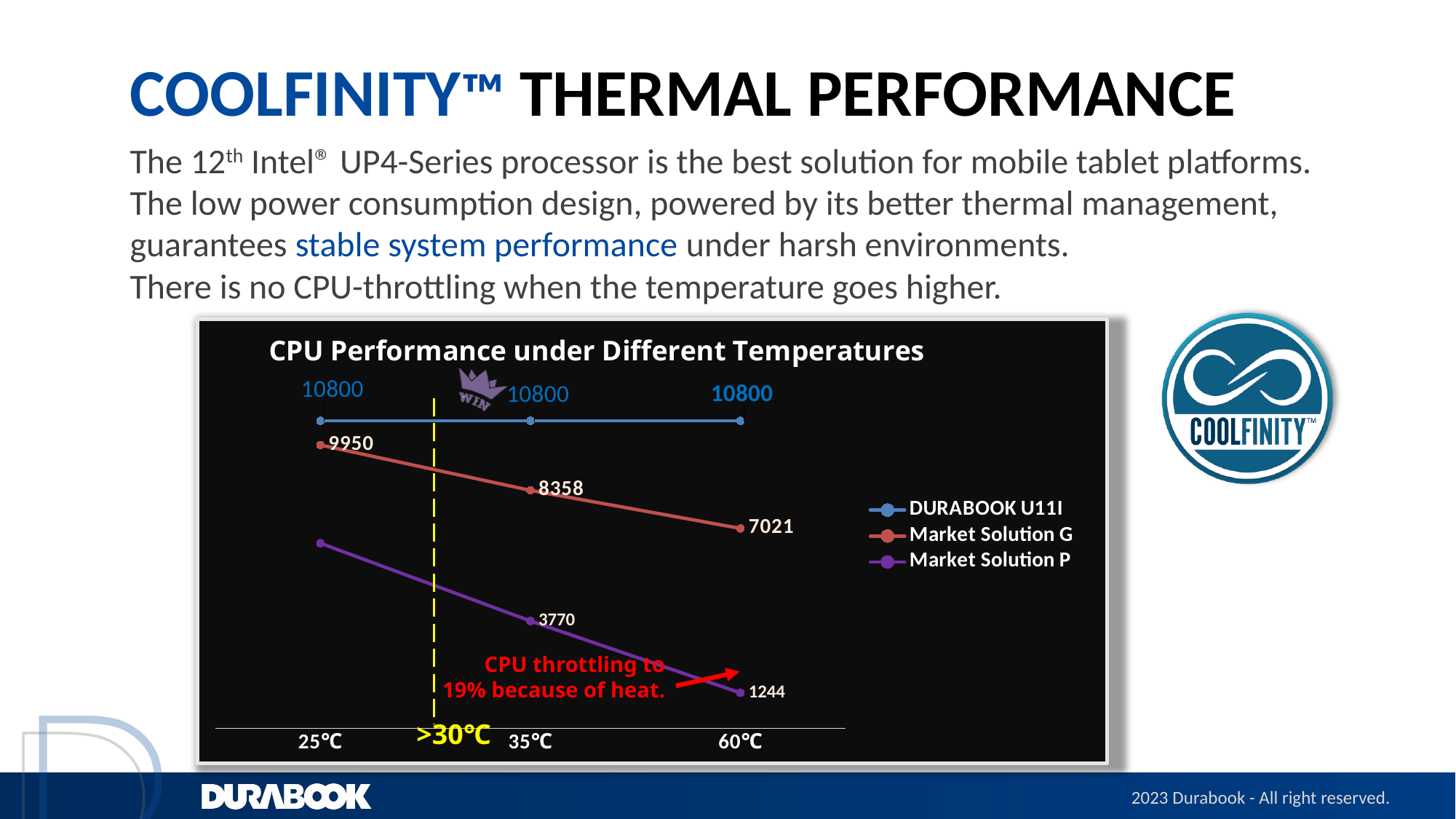
Which series has the lowest value at 60°C? Market Solution P What is the value for Market Solution P at 60°C? 1244 Which is larger at 35°C: the value for Market Solution G or the value for Market Solution P? Market Solution G What is the value for Market Solution G at 25°C? 9950 What is the difference between Market Solution G's values at 25°C and 60°C? 2929 How many series does the legend list? 3 How many temperature categories are shown on the x axis? 3 What is the value for Market Solution G at 35°C? 8358 What is the value for DURABOOK U11I at 60°C? 10800 What is the title of the chart? CPU Performance under Different Temperatures What type of chart is shown on the slide? line chart Do the values for Market Solution P rise or fall as temperature increases along the x axis? fall